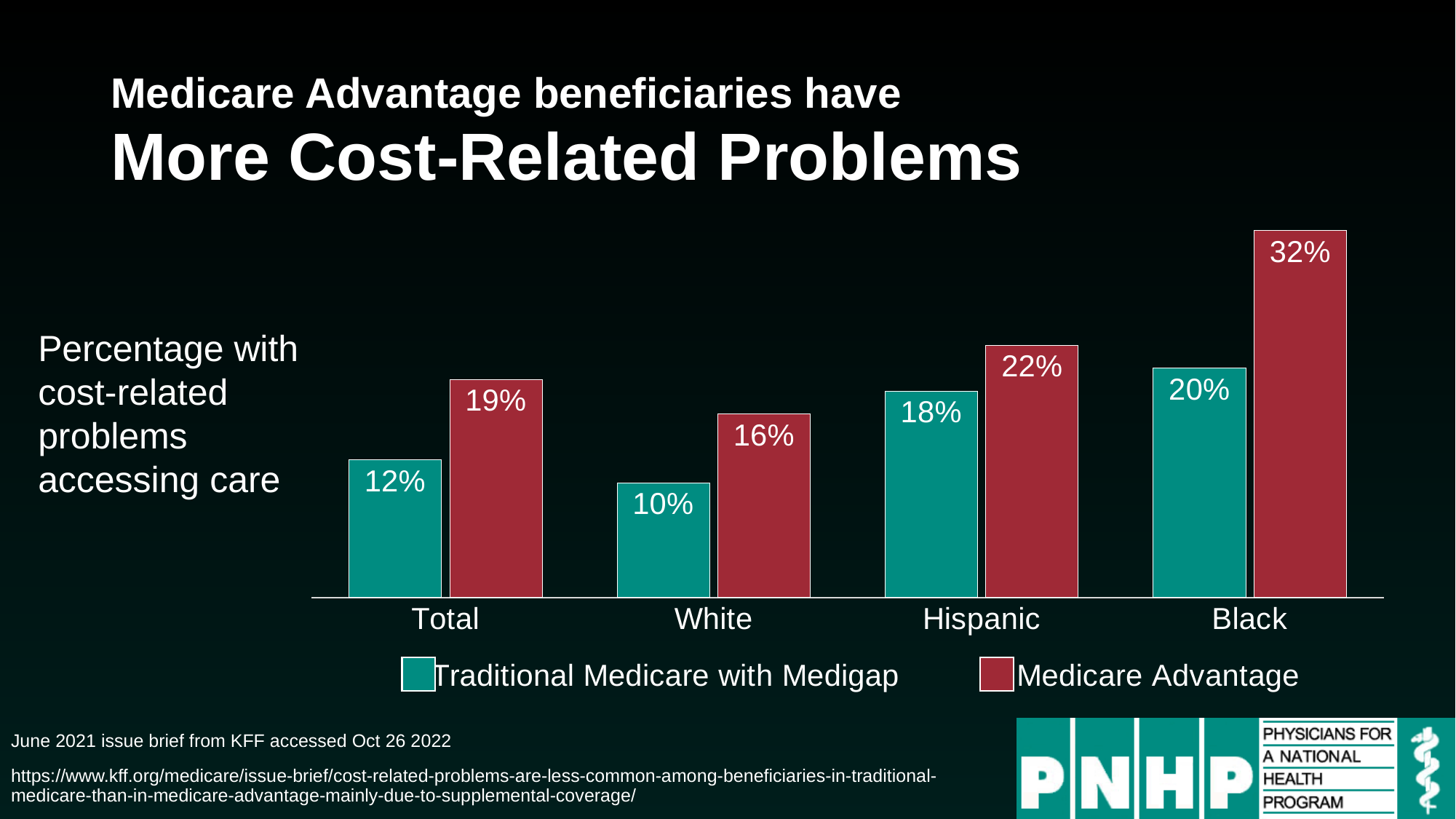
What is the Medicare Advantage value for Black beneficiaries? 32% What is the Traditional Medicare with Medigap value for Hispanic beneficiaries? 18% Which colour represents Medicare Advantage in the legend? Red Which category has the lowest Traditional Medicare with Medigap value? White How many series does the legend list? 2 How many categories are shown on the x axis? 4 Which category has the highest Medicare Advantage value? Black Which is larger for Hispanic beneficiaries: the Medicare Advantage value or the Traditional Medicare with Medigap value? Medicare Advantage What is the Medicare Advantage value for the Total category? 19% What kind of chart is shown on the slide? Bar chart What is the difference between the Medicare Advantage and Traditional Medicare with Medigap values for Black beneficiaries? 12% What is the Traditional Medicare with Medigap value for White beneficiaries? 10%